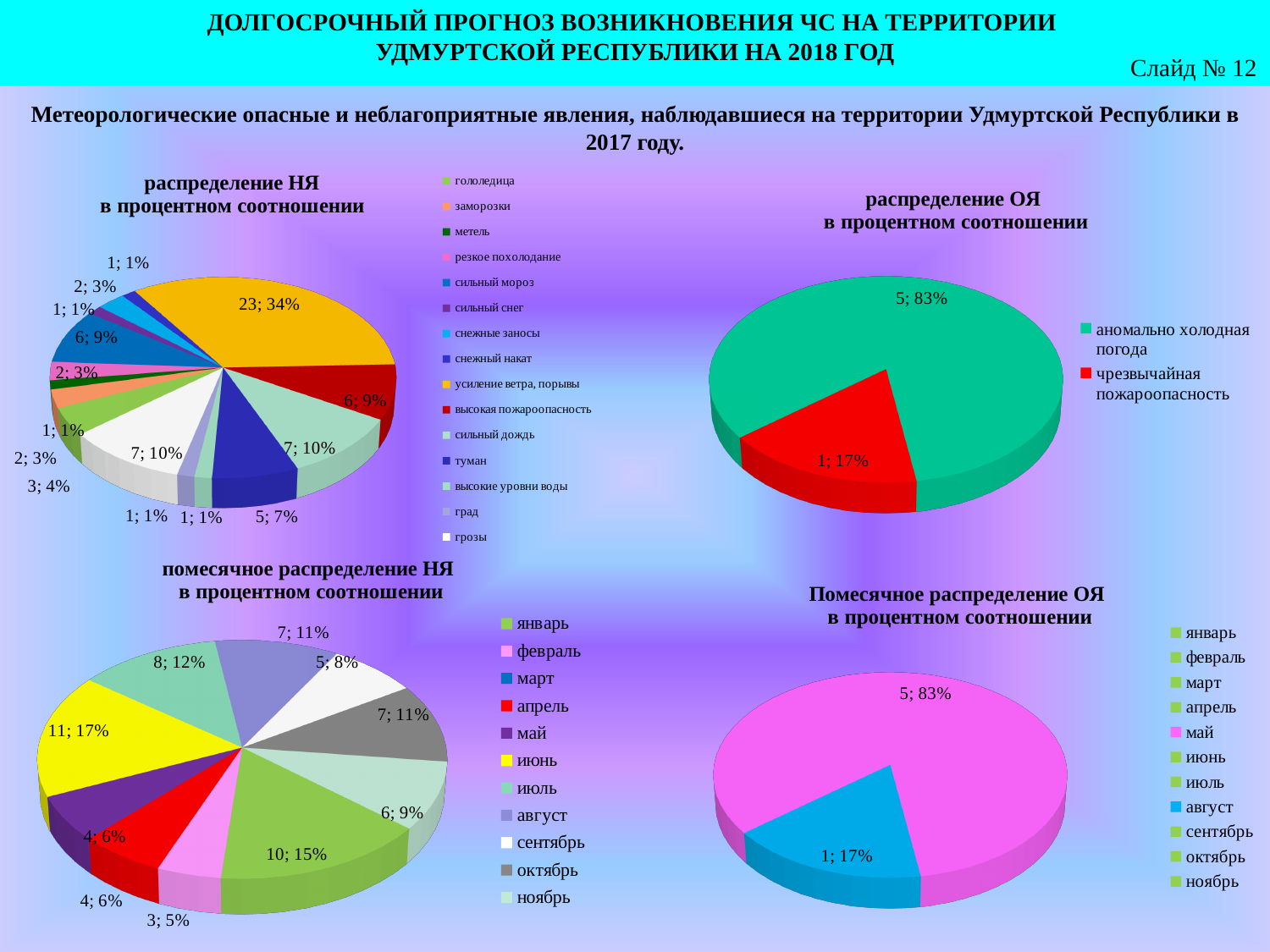
In the chart titled «помесячное распределение НЯ в процентном соотношении», which is larger, the slice for «июнь» or the slice for «январь»? июнь In the chart titled «распределение ОЯ в процентном соотношении», what share of the pie is «аномально холодная погода»? 83% In the chart titled «Помесячное распределение ОЯ в процентном соотношении», what share of the pie is «май»? 83% In the chart titled «помесячное распределение НЯ в процентном соотношении», which month has the largest slice? июнь In the chart titled «распределение НЯ в процентном соотношении», what is the data label of the largest slice? 23; 34% How many entries does the legend of the chart titled «распределение ОЯ в процентном соотношении» list? 2 In the chart titled «помесячное распределение НЯ в процентном соотношении», what is the data label for «июнь»? 11; 17% What kind of chart is the chart titled «Помесячное распределение ОЯ в процентном соотношении»? pie chart How many entries does the legend of the chart titled «распределение НЯ в процентном соотношении» list? 15 In the chart titled «Помесячное распределение ОЯ в процентном соотношении», which month has the smaller slice? август How many entries does the legend of the chart titled «помесячное распределение НЯ в процентном соотношении» list? 11 In the chart titled «распределение ОЯ в процентном соотношении», what is the data label for «чрезвычайная пожароопасность»? 1; 17%